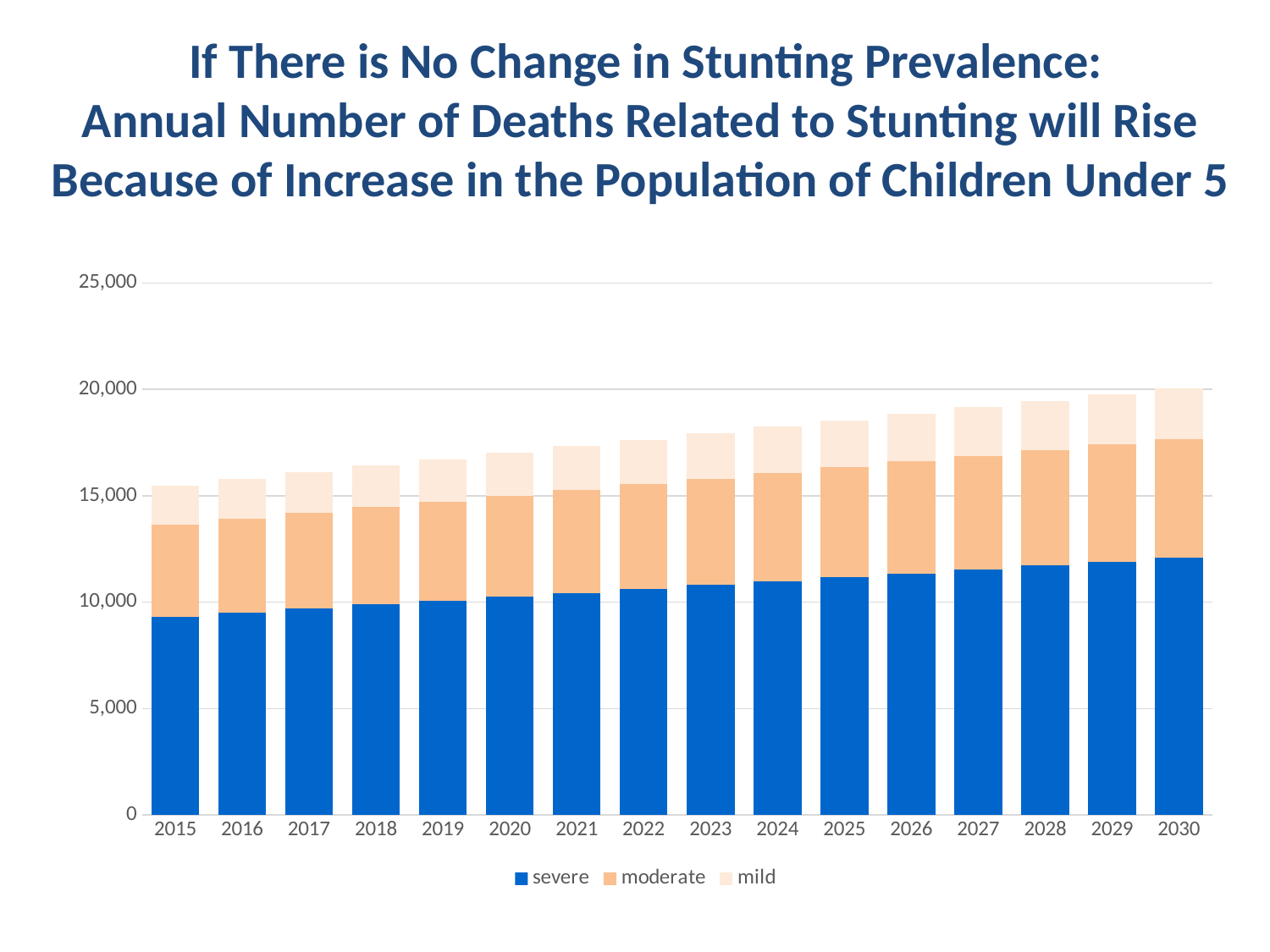
Is the value for severe in 2015 greater or less than 10,000? less Do the total annual deaths rise or fall from 2015 to 2030? Rise Which year has the lowest total number of deaths? 2015 Is the total bar for 2015 greater or less than 15,000? greater How many years are shown along the x axis? 16 Which year has the highest total number of deaths? 2030 How many series does the legend list? 3 Is the total bar for 2020 greater or less than 20,000? less Which is larger, the severe value in 2030 or the severe value in 2015? 2030 What kind of chart is shown on the slide? Stacked bar chart Which series are listed in the legend? severe, moderate, mild